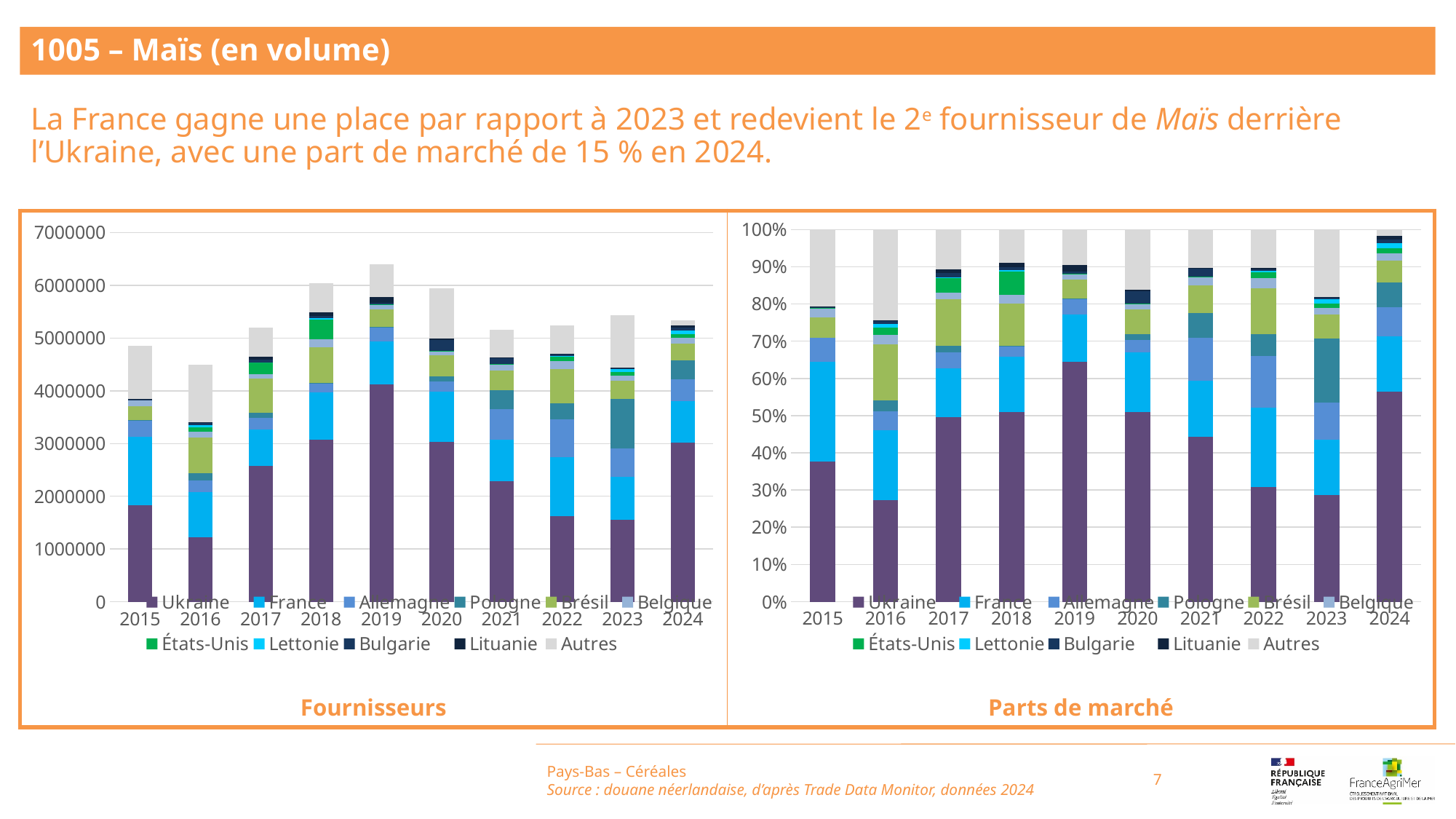
How many years are shown on the x axis of the 'Parts de marché' chart? 10 In the 'Parts de marché' chart, is the Ukraine share for 2016 greater or less than 30%? less In the 'Fournisseurs' chart, is the total bar for 2019 greater or less than 6000000? greater In the 'Fournisseurs' chart, is the Ukraine value for 2015 greater or less than 2000000? less In the 'Parts de marché' chart, is the Ukraine share larger in 2019 or in 2016? 2019 What kind of chart is the 'Fournisseurs' chart on the left? Stacked bar chart In the 'Parts de marché' chart, does the Ukraine share rise or fall from 2021 to 2023? fall In the 'Fournisseurs' chart, which year has the shortest total bar? 2016 How many series does the legend of the 'Fournisseurs' chart list? 11 In the 'Fournisseurs' chart, which year has the tallest total bar? 2019 What is the title of the chart on the right side of the slide? Parts de marché